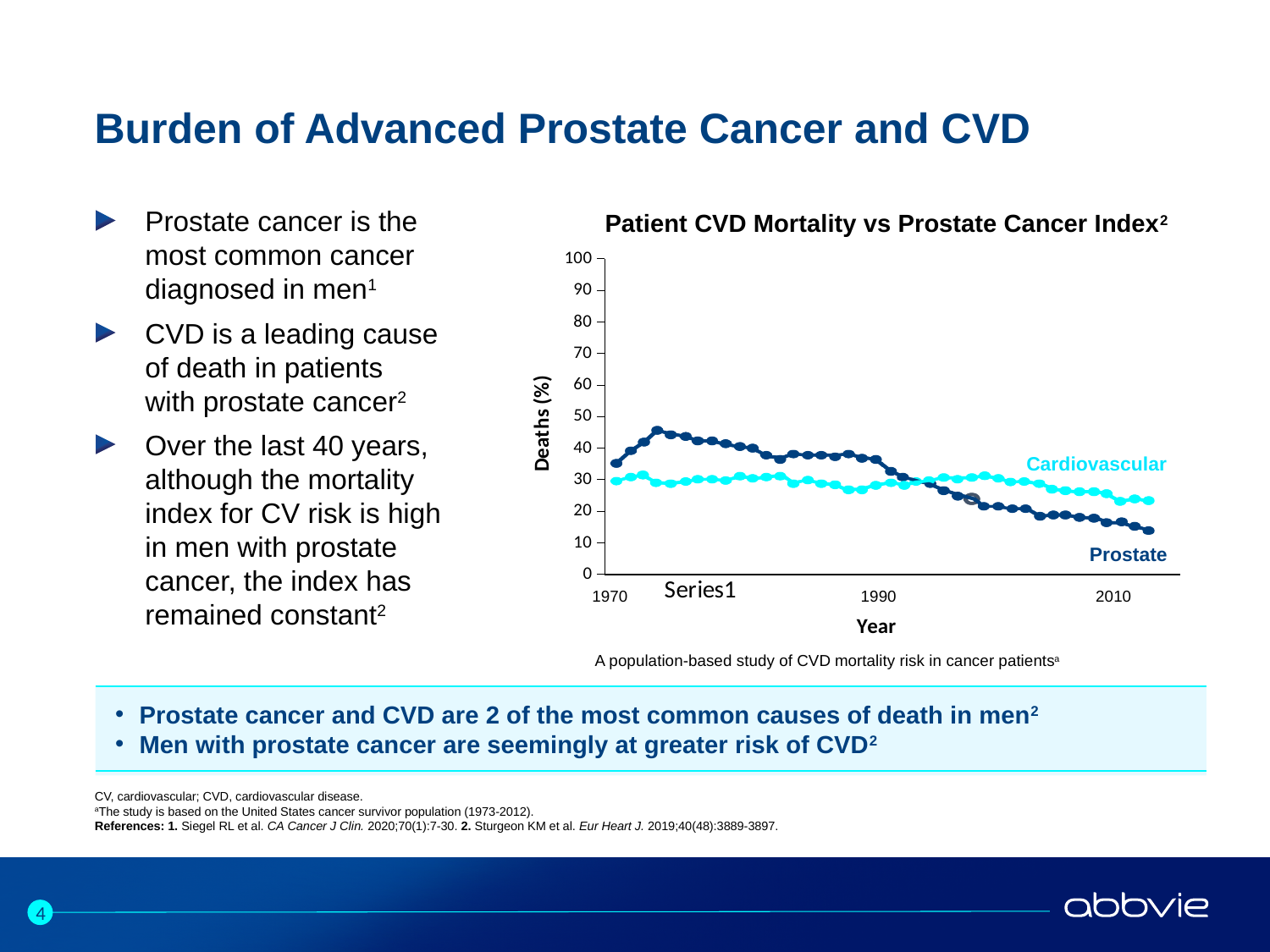
What is the label of the vertical axis of the chart? Deaths (%) How many data series are plotted in the chart? 2 Does the Prostate line rise or fall from 1970 to 2010? fall Is the value of the Prostate line in 1970 greater or less than 30? greater What is the title of the chart? Patient CVD Mortality vs Prostate Cancer Index In 1970, which line is higher, Prostate or Cardiovascular? Prostate In 2010, which line is higher, Prostate or Cardiovascular? Cardiovascular Is the peak value of the Prostate line greater or less than 40? greater Is the value of the Prostate line in 2010 greater or less than 20? less What kind of chart is shown on the slide? line chart What is the highest value shown on the vertical axis of the chart? 100